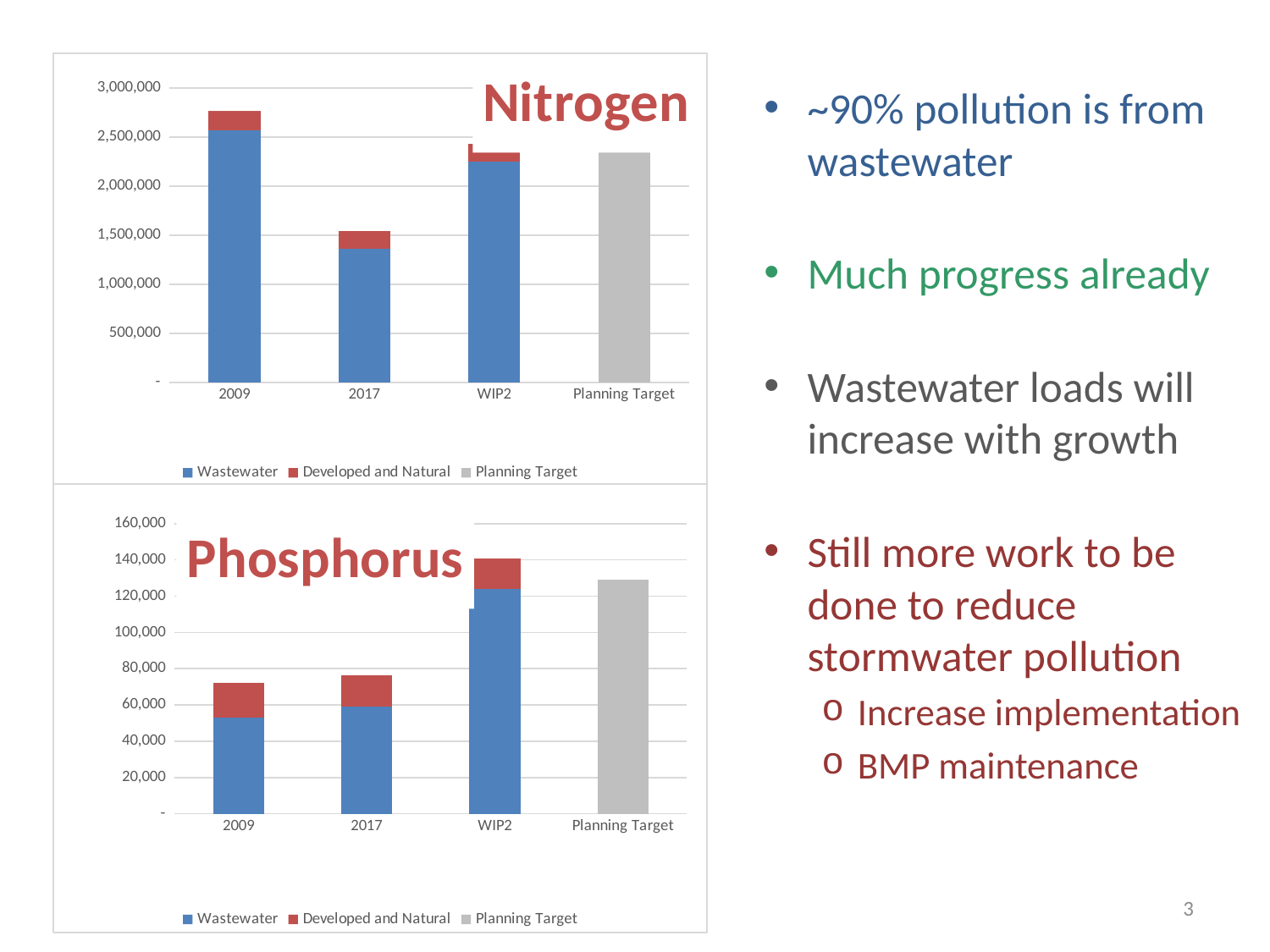
In the Nitrogen chart, which category has the shortest bar? 2017 In the Phosphorus chart, is the total value for WIP2 greater or less than 120,000? greater How many categories are shown on the x axis of the Phosphorus chart? 4 In the Nitrogen chart, which series is shown in blue? Wastewater In the Nitrogen chart, is the total value for 2017 greater or less than 2,000,000? less In the Nitrogen chart, is the total value for 2009 greater or less than 2,500,000? greater In the Nitrogen chart, which category has the tallest bar? 2009 What kind of chart is the Nitrogen chart? bar chart In the Phosphorus chart, which category has the tallest bar? WIP2 How many series does the legend of the Nitrogen chart list? 3 In the Phosphorus chart, which bar is taller, WIP2 or Planning Target? WIP2